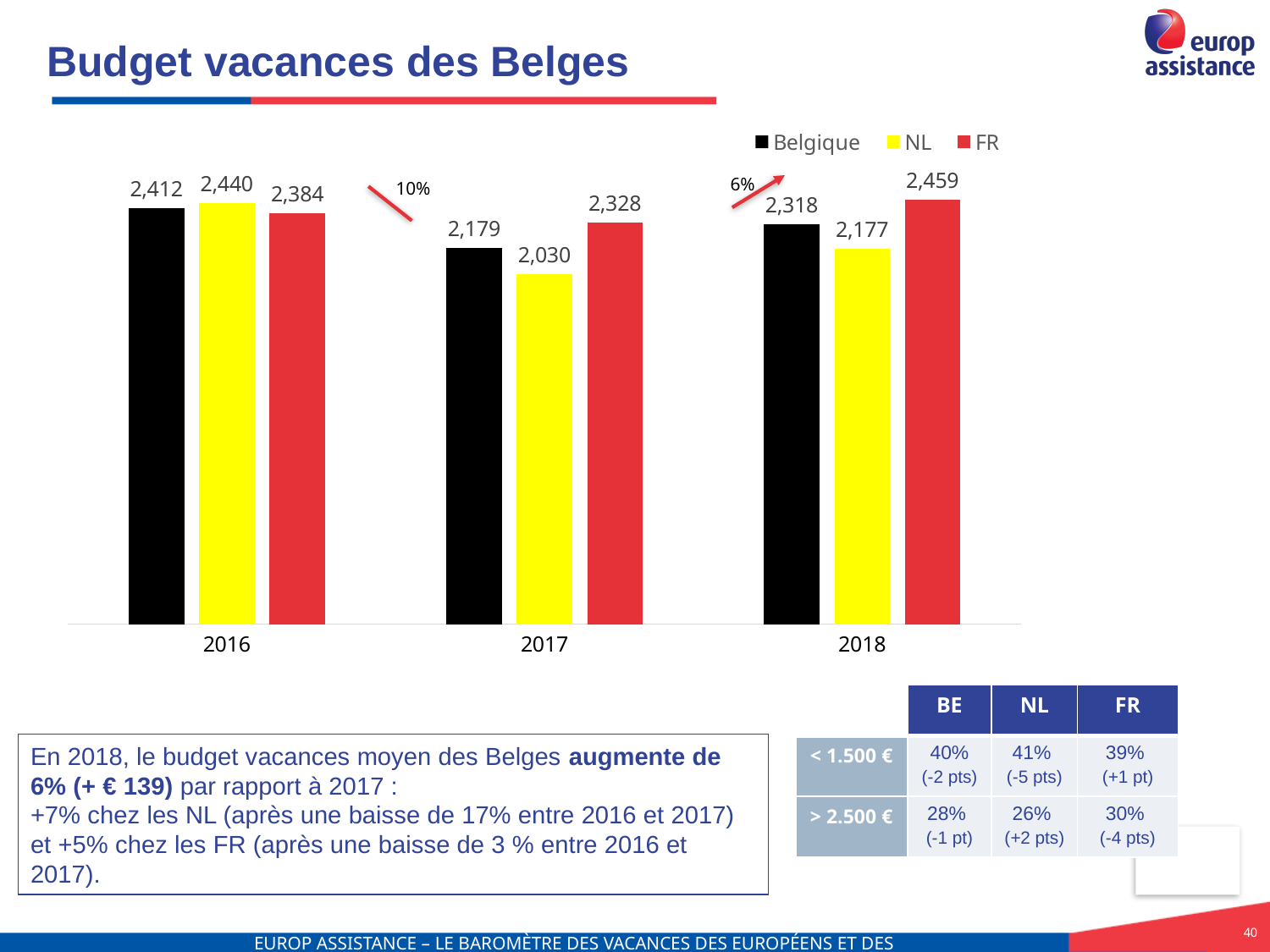
What is the value for Belgique in 2018? 2,318 What is the difference between the Belgique values for 2018 and 2017? 139 How many years are shown on the x axis? 3 Which is larger, the NL value in 2016 or the NL value in 2018? NL value in 2016 What is the value for NL in 2017? 2,030 Which series has the highest value in 2018? FR Does the NL value rise or fall from 2016 to 2017? Fall What kind of chart is shown on the slide? Bar chart What is the value for Belgique in 2016? 2,412 What is the value for FR in 2018? 2,459 How many series does the legend list? 3 Which series has the lowest value in 2017? NL